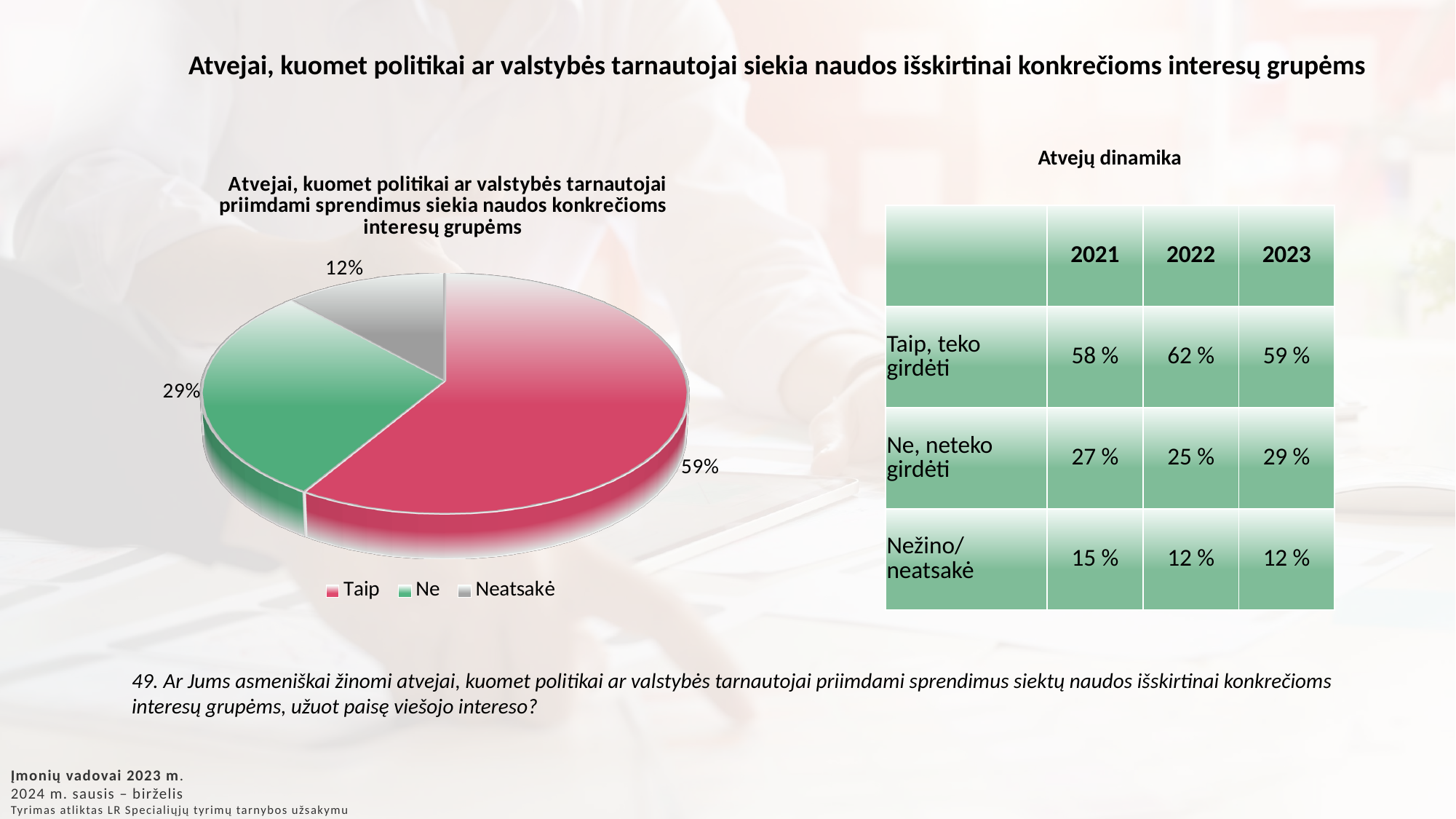
How many entries does the pie chart's legend list? 3 Which slice of the pie chart is the smallest? Neatsakė What is the difference in percentage points between the "Ne" and "Neatsakė" slices? 17 Which slice of the pie chart is the largest? Taip What share of the pie does the "Taip" slice represent? 59% How many slices does the pie chart have? 3 What share of the pie does the "Ne" slice represent? 29% What kind of chart is shown on the slide? pie chart What is the difference in percentage points between the "Taip" and "Ne" slices? 30 Which is larger, the "Ne" slice or the "Neatsakė" slice? Ne What share of the pie does the "Neatsakė" slice represent? 12% What colour is the "Taip" slice in the pie chart? red